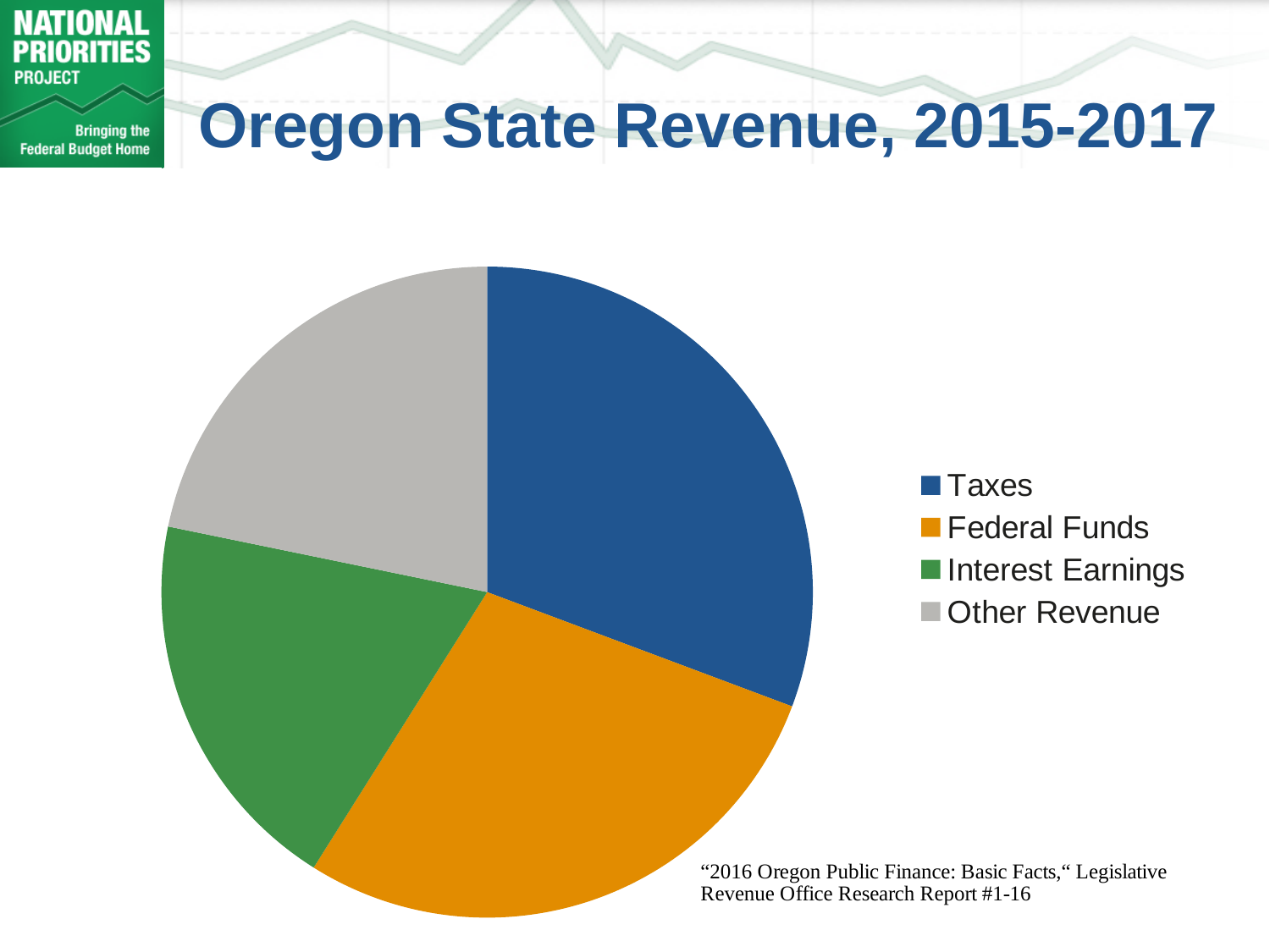
Which slice is larger, Federal Funds or Interest Earnings? Federal Funds What is the title of the chart on the slide? Oregon State Revenue, 2015-2017 How many slices does the pie chart have? 4 What colour is the Taxes slice in the pie chart? blue Which slice is larger, Federal Funds or Other Revenue? Federal Funds Which slice is larger, Taxes or Other Revenue? Taxes What kind of chart is shown on the slide? pie chart How many entries does the legend list? 4